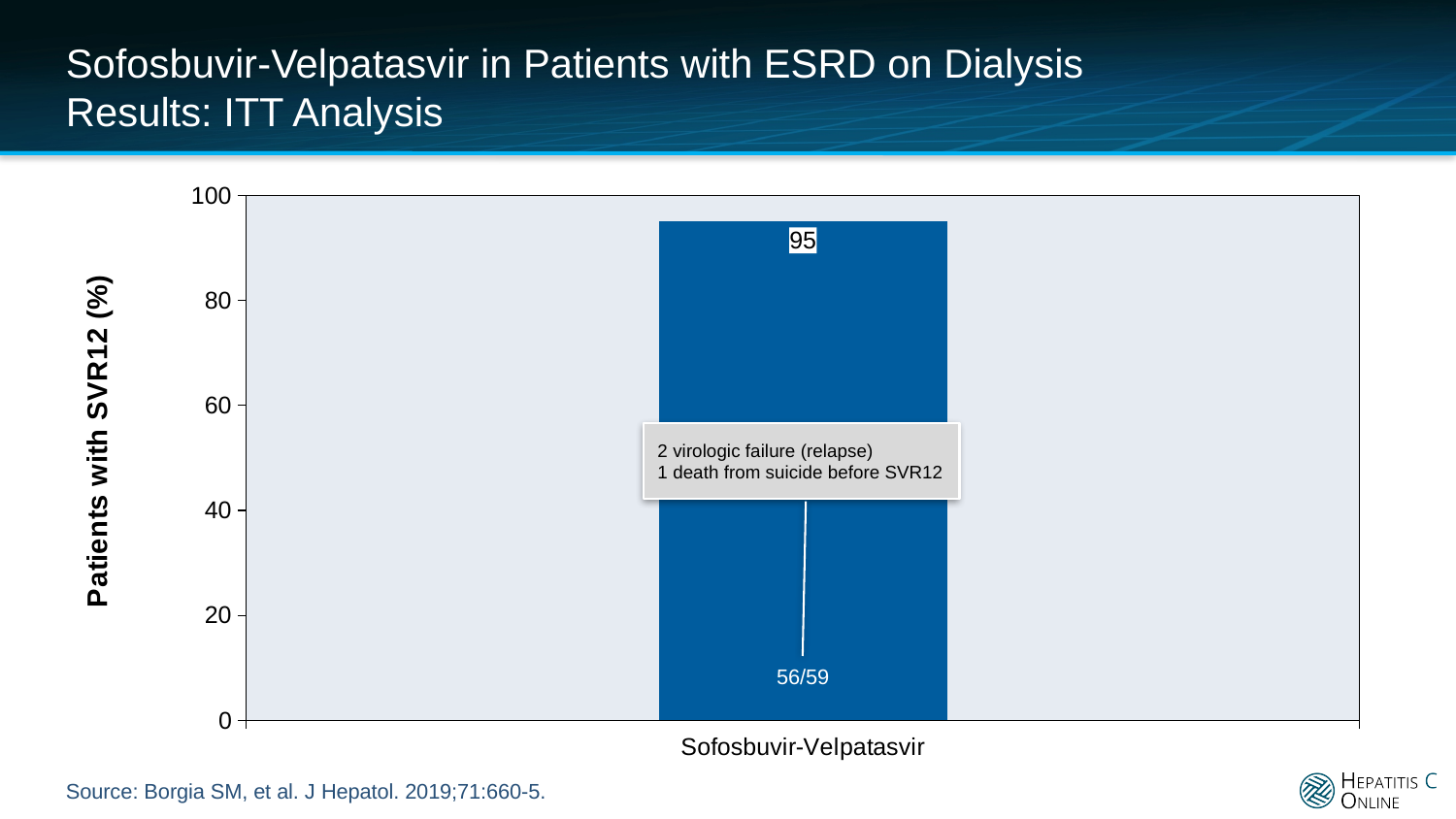
How many bars are plotted in the chart? 1 Is the value for Sofosbuvir-Velpatasvir greater or less than 80? greater What is the SVR12 rate (%) shown for Sofosbuvir-Velpatasvir? 95 Is the value for Sofosbuvir-Velpatasvir greater or less than 100? less What is the label of the y axis? Patients with SVR12 (%) What kind of chart is shown on the slide? bar chart What fraction of patients (n/N) is printed on the Sofosbuvir-Velpatasvir bar? 56/59 What is the category label on the x axis? Sofosbuvir-Velpatasvir What is the maximum value shown on the y axis? 100 According to the callout on the chart, how many deaths from suicide before SVR12 occurred? 1 According to the callout on the chart, how many virologic failures (relapse) occurred? 2